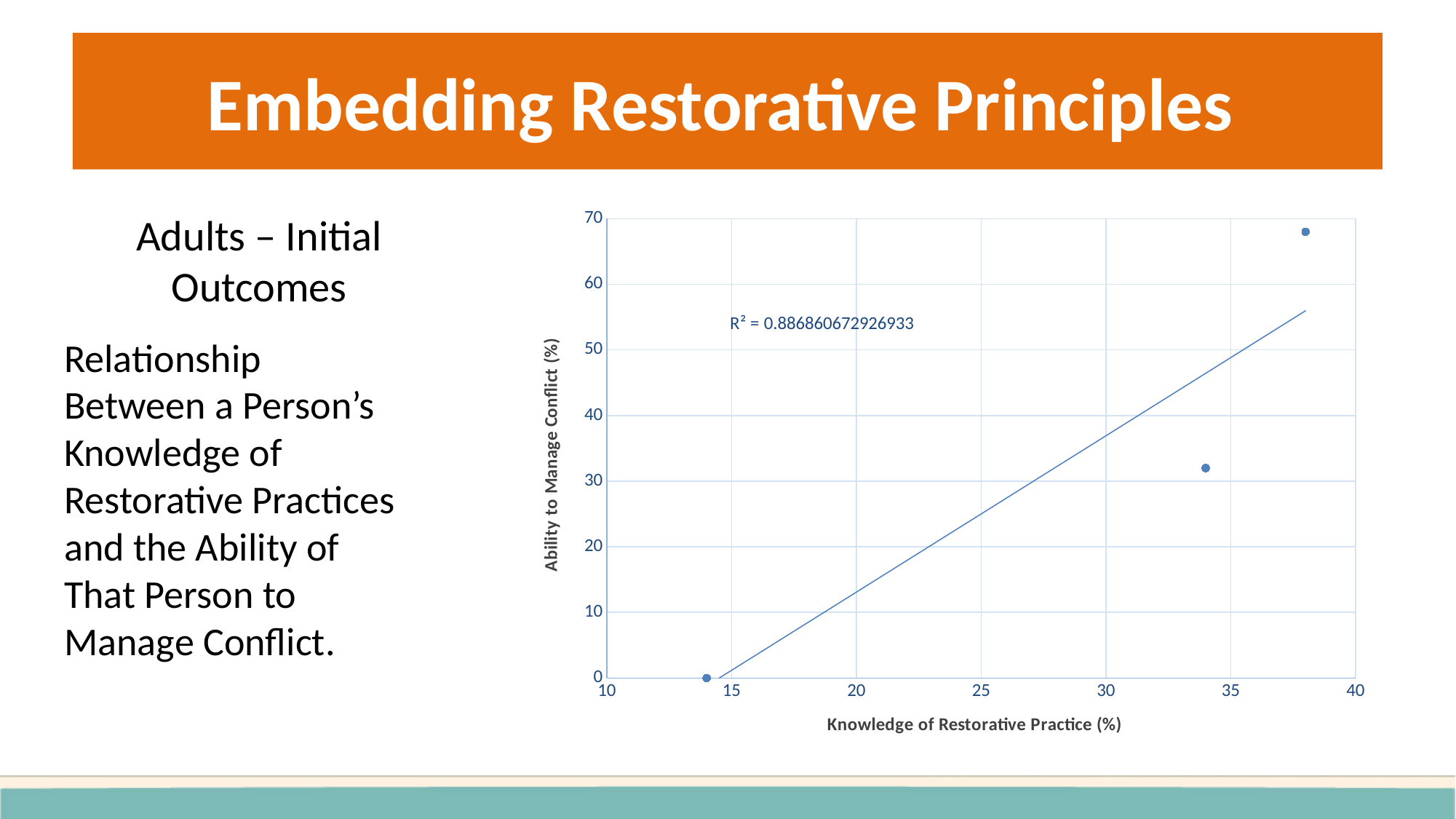
Which has the higher Ability to Manage Conflict: the point with the highest Knowledge of Restorative Practice or the point with the lowest Knowledge of Restorative Practice? The point with the highest Knowledge of Restorative Practice What is the title of the x axis of the chart? Knowledge of Restorative Practice (%) Do the plotted values of Ability to Manage Conflict rise or fall as Knowledge of Restorative Practice increases? Rise Is the Ability to Manage Conflict value for the point with the highest Knowledge of Restorative Practice greater or less than 60? greater What is the maximum value shown on the y axis of the chart? 70 Is the Knowledge of Restorative Practice value for the point with the lowest Ability to Manage Conflict greater or less than 15? less What R² value is printed on the chart? R² = 0.886860672926933 What kind of chart is shown on the slide? Scatter chart Is the Ability to Manage Conflict value for the point with Knowledge of Restorative Practice between 30 and 35 greater or less than 40? less What is the Ability to Manage Conflict value for the lowest plotted point? 0